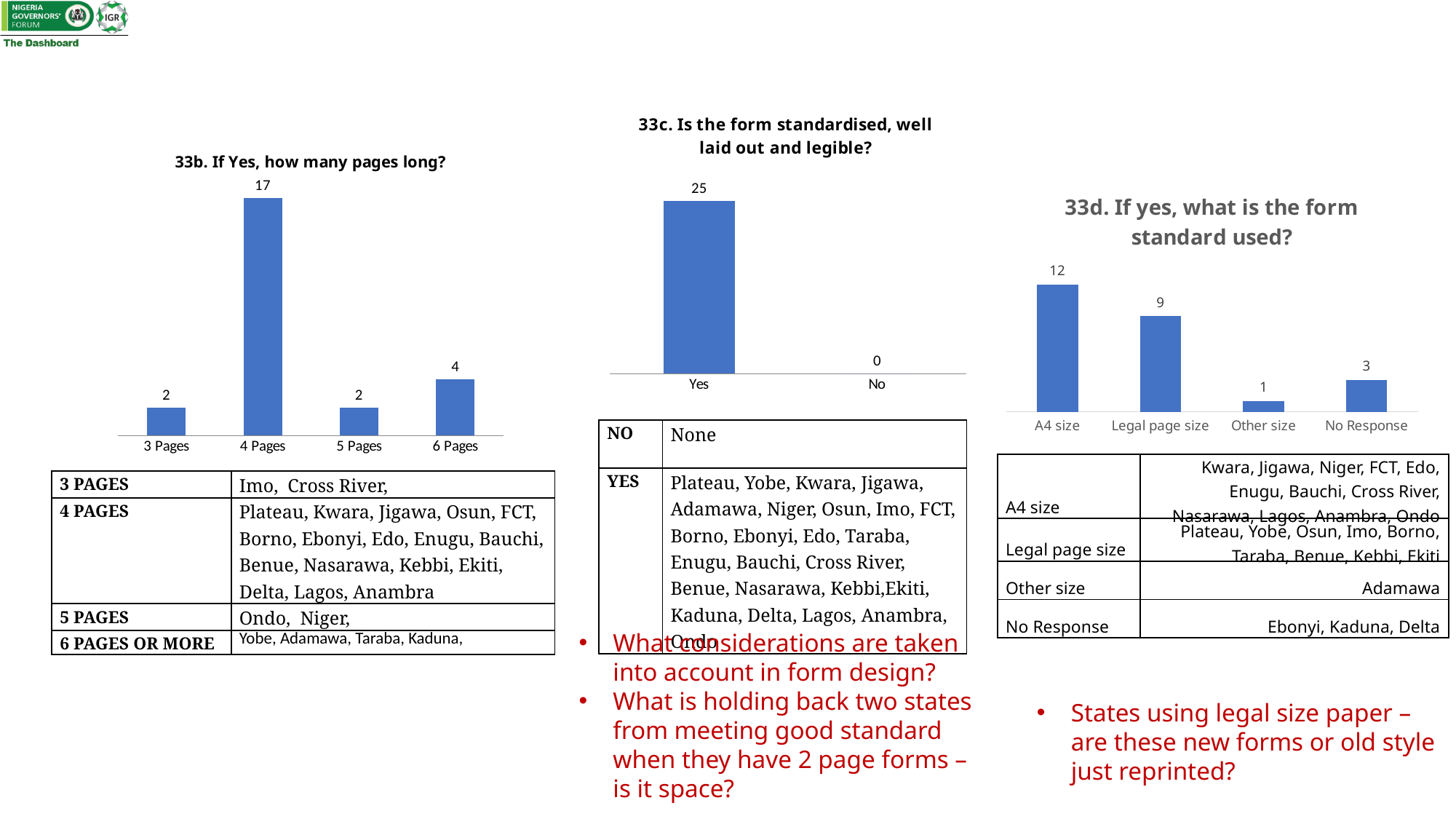
In the chart '33d. If yes, what is the form standard used?', which category has the lowest value? Other size What kind of chart is '33c. Is the form standardised, well laid out and legible?'? Bar chart In the chart '33b. If Yes, how many pages long?', what is the difference between the values for 4 Pages and 6 Pages? 13 In the chart '33d. If yes, what is the form standard used?', which is larger: A4 size or No Response? A4 size How many categories are shown in the chart '33b. If Yes, how many pages long?'? 4 In the chart '33c. Is the form standardised, well laid out and legible?', what is the value for No? 0 How many categories are shown in the chart '33d. If yes, what is the form standard used?'? 4 In the chart '33d. If yes, what is the form standard used?', what is the difference between A4 size and Legal page size? 3 In the chart '33b. If Yes, how many pages long?', what is the value for 4 Pages? 17 In the chart '33b. If Yes, how many pages long?', which category has the highest value? 4 Pages In the chart '33c. Is the form standardised, well laid out and legible?', what is the value for Yes? 25 In the chart '33d. If yes, what is the form standard used?', what is the value for Legal page size? 9